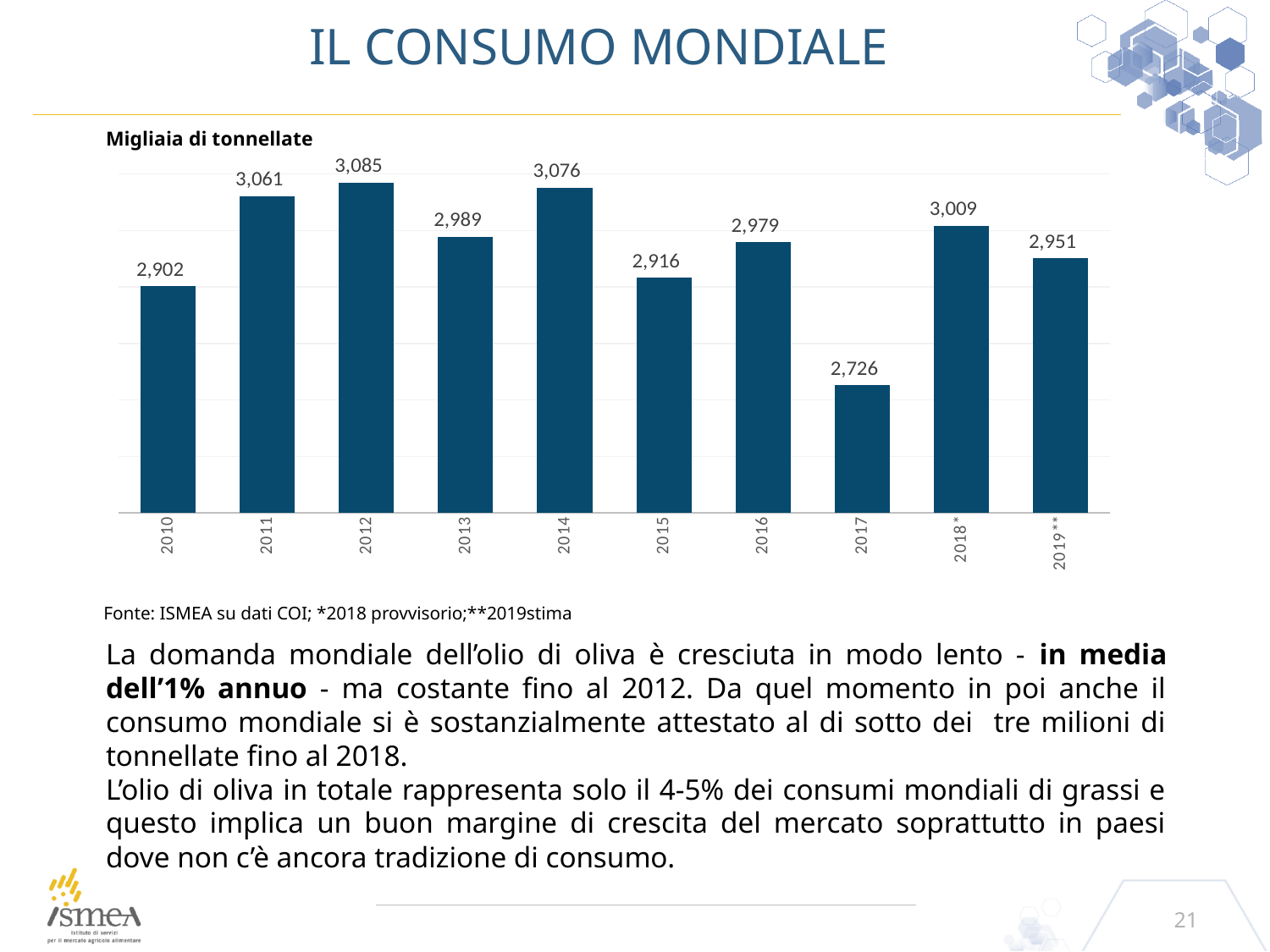
Which year has the highest value? 2012 What is the value for 2017? 2,726 What kind of chart is shown on the slide? Bar chart What unit is stated above the chart? Migliaia di tonnellate What is the value for 2019**? 2,951 What is the difference between the values for 2018* and 2019**? 58 What is the difference between the values for 2012 and 2017? 359 Which year has the lowest value? 2017 Which is larger, the value for 2010 or the value for 2015? 2015 What is the value for 2012? 3,085 Which is larger, the value for 2011 or the value for 2014? 2014 How many years are shown on the x axis? 10